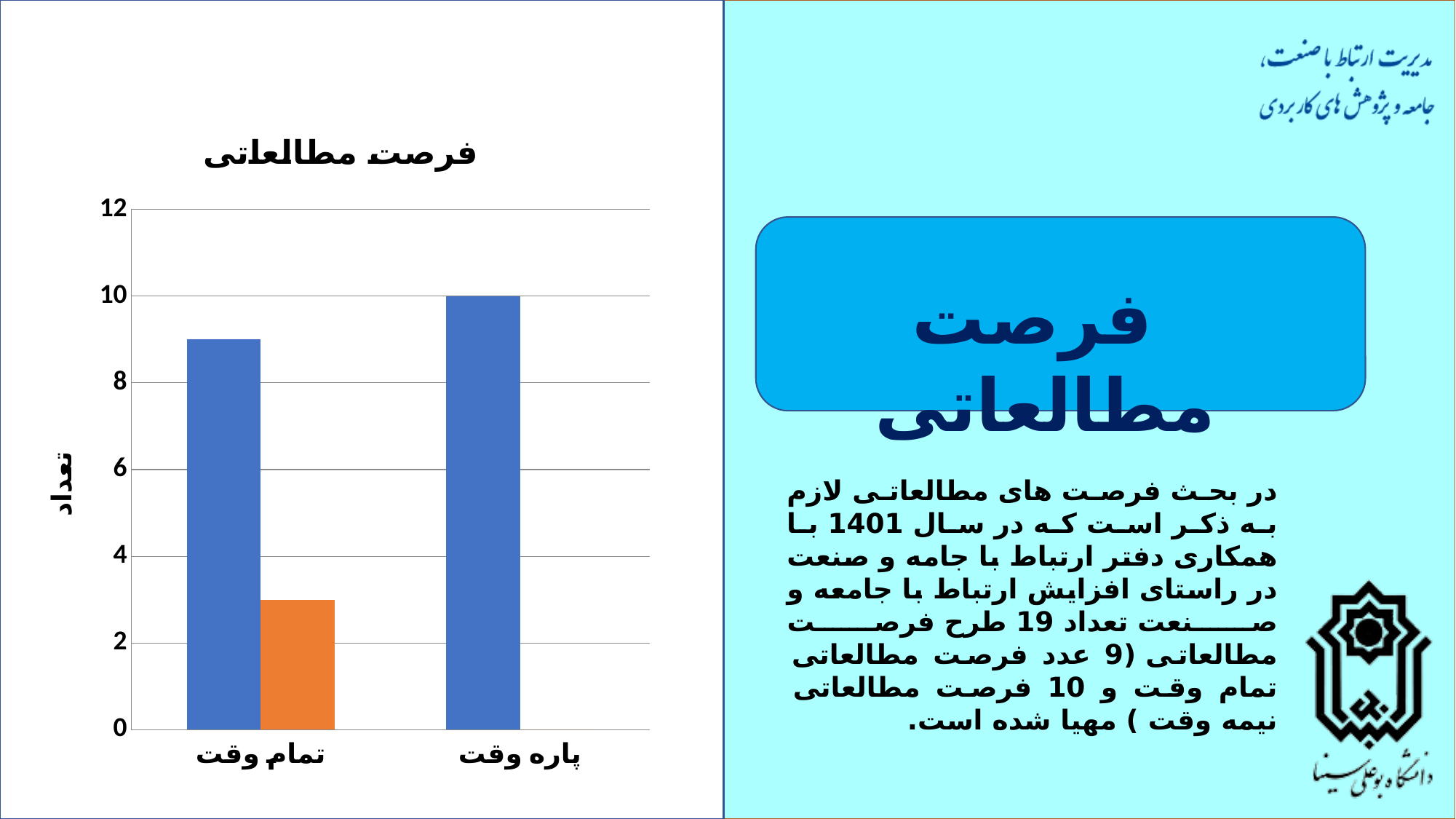
Which category has the tallest bar in the chart? پاره وقت Is the value of the orange bar for تمام وقت greater or less than 4? less What kind of chart is shown on the slide? bar chart How many bars are plotted in the chart in total? 3 Which is larger: the blue bar for تمام وقت or the blue bar for پاره وقت? پاره وقت Is the value of the blue bar for تمام وقت greater or less than 8? greater Is the value of the orange bar for تمام وقت greater or less than 2? greater What is the title of the chart? فرصت مطالعاتی What is the value of the blue bar for پاره وقت? 10 What is the label on the vertical axis of the chart? تعداد How many categories are shown on the x axis of the chart? 2 Which bar is the shortest in the chart? the orange bar for تمام وقت